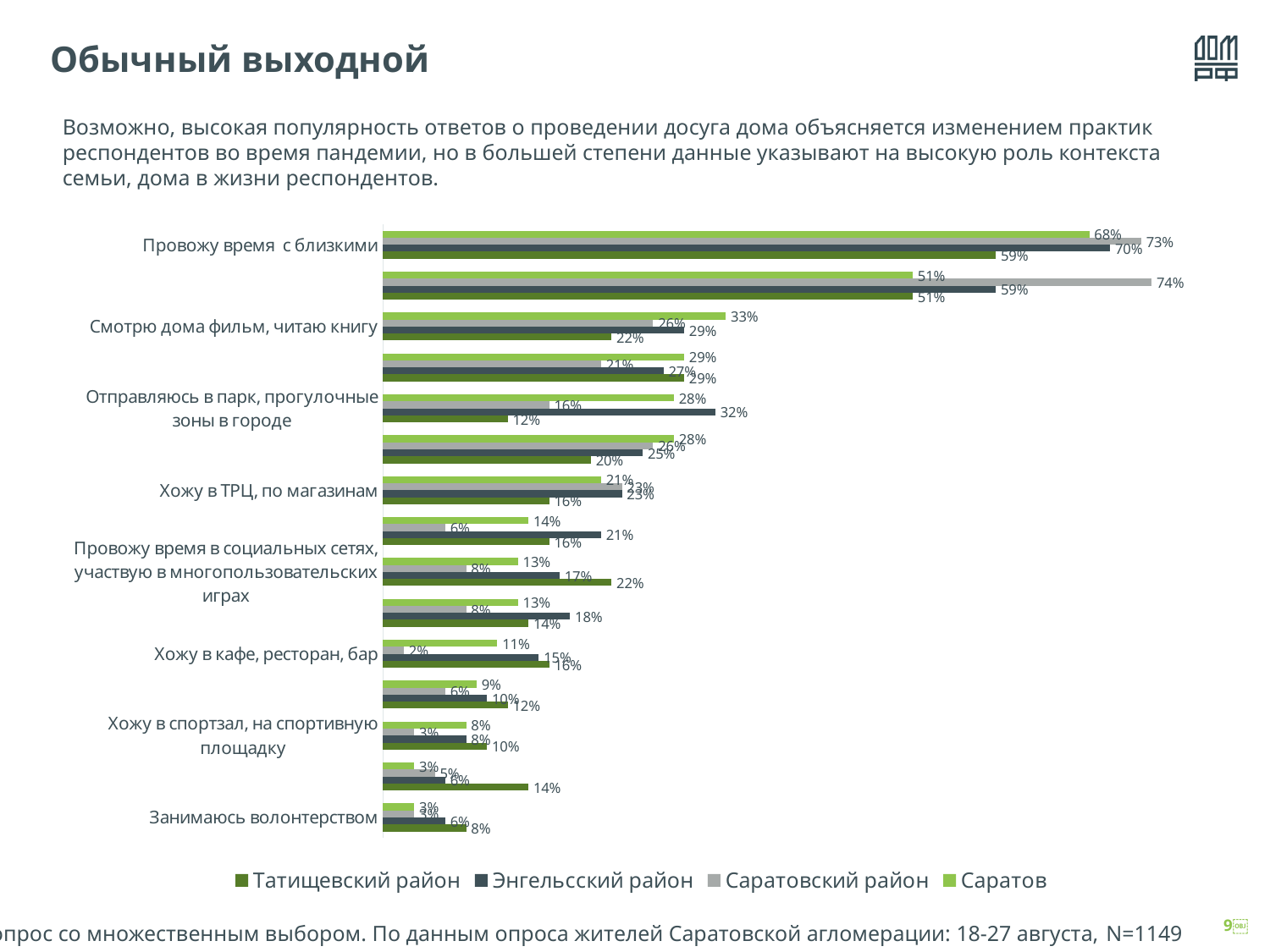
What is the value for Саратов in the category "Смотрю дома фильм, читаю книгу"? 33% In the category "Провожу время с близкими", which series has the highest value? Саратовский район How many series does the legend list? 4 In the category "Отправляюсь в парк, прогулочные зоны в городе", what is the difference between Энгельсский район and Татищевский район? 20 percentage points What is the value for Саратовский район in the category "Хожу в кафе, ресторан, бар"? 2% In the category "Отправляюсь в парк, прогулочные зоны в городе", which series has the lowest value? Татищевский район In the category "Хожу в кафе, ресторан, бар", which is larger: Татищевский район or Саратов? Татищевский район What is the value for Татищевский район in the category "Занимаюсь волонтерством"? 8% Which series are listed in the chart legend? Татищевский район, Энгельсский район, Саратовский район, Саратов What is the value for Энгельсский район in the category "Отправляюсь в парк, прогулочные зоны в городе"? 32% What is the value for Татищевский район in the category "Провожу время с близкими"? 59% What type of chart is shown on the slide? Bar chart